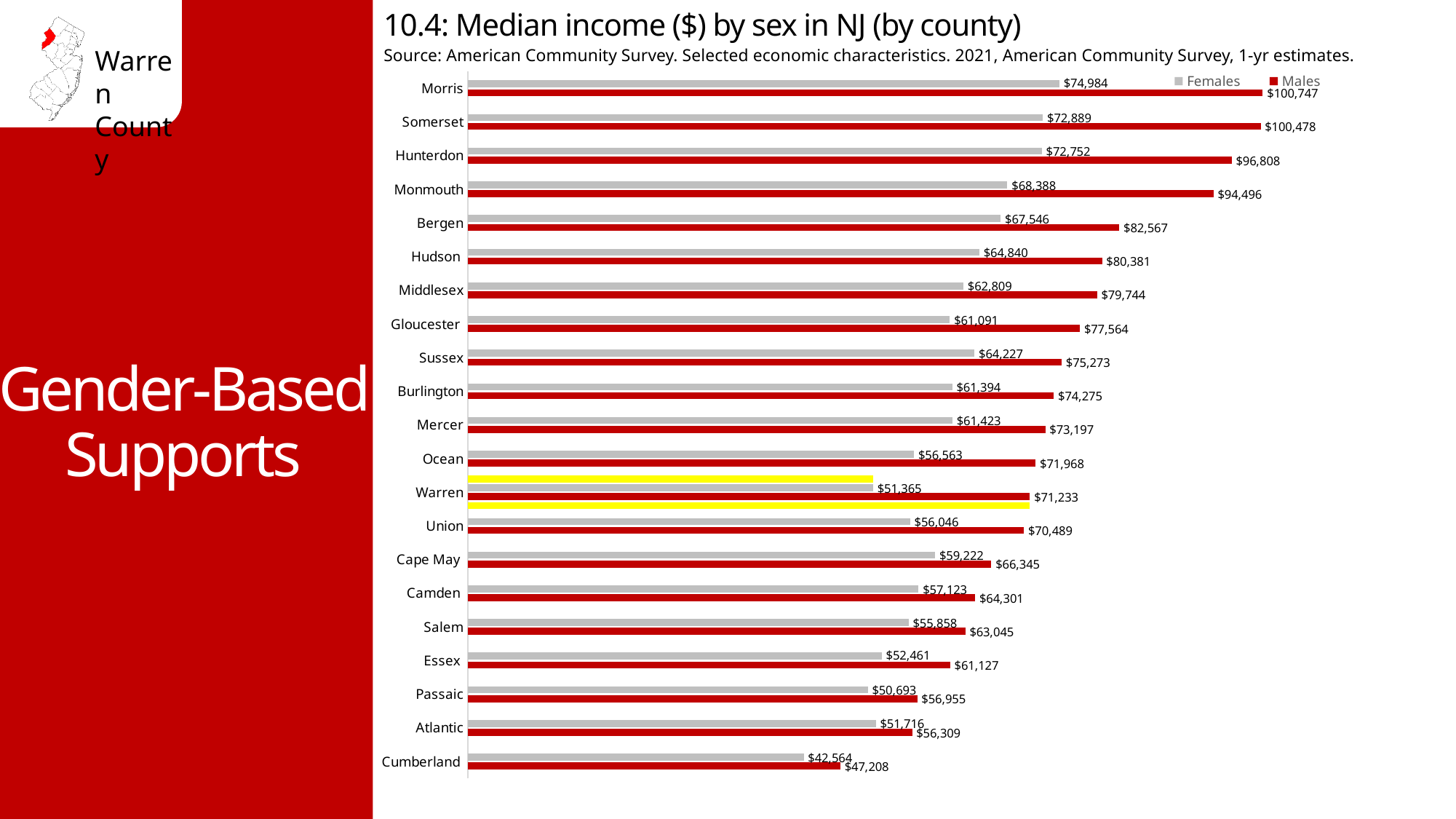
Which county has the highest median income for females? Morris What is the difference between male and female median income in Morris County? $25,763 What kind of chart is shown on the slide? Bar chart What is the median income for females in Cape May County? $59,222 What is the median income for males in Hunterdon County? $96,808 Which is larger, the female median income in Sussex County or in Gloucester County? Sussex What is the median income for males in Warren County? $71,233 How many series does the legend list? 2 What is the difference between male and female median income in Warren County? $19,868 Which county has the lowest median income for males? Cumberland How many counties are shown in the chart? 21 What is the median income for females in Warren County? $51,365